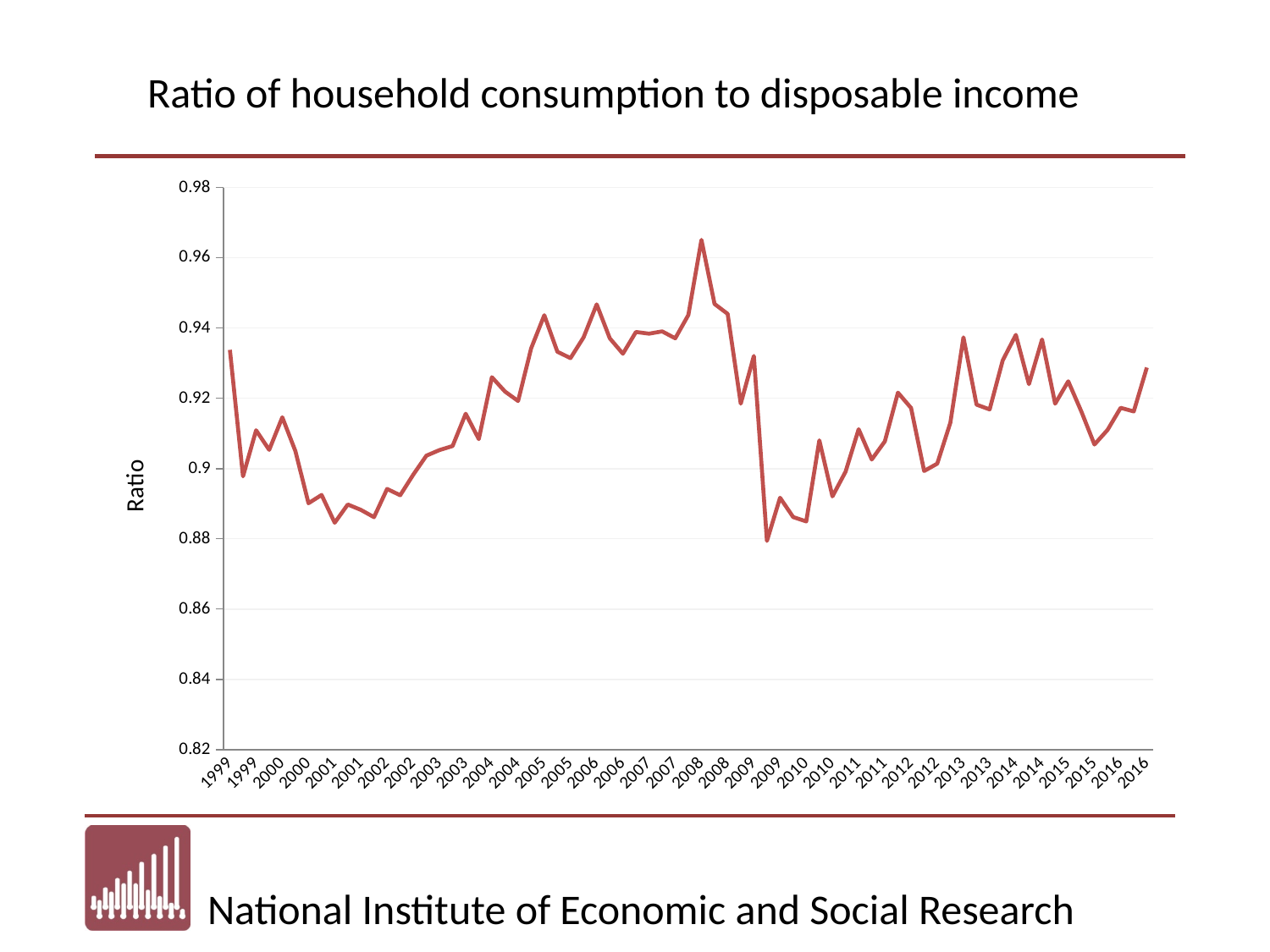
In which year does the line reach its lowest point? 2009 Which is lower, the trough in 2001 or the trough in 2009? 2009 What is the title of the chart? Ratio of household consumption to disposable income What kind of chart is shown on the slide? line chart Does the ratio generally rise or fall between 2001 and 2005? rise In which year does the line reach its highest point? 2008 Is the lowest value in 2009 greater or less than 0.9? less Is the peak value in 2008 greater or less than 0.94? greater Is the lowest value in 2001 greater or less than 0.9? less Which is higher, the peak in 2008 or the peak in 2013? 2008 What is the label on the vertical axis of the chart? Ratio